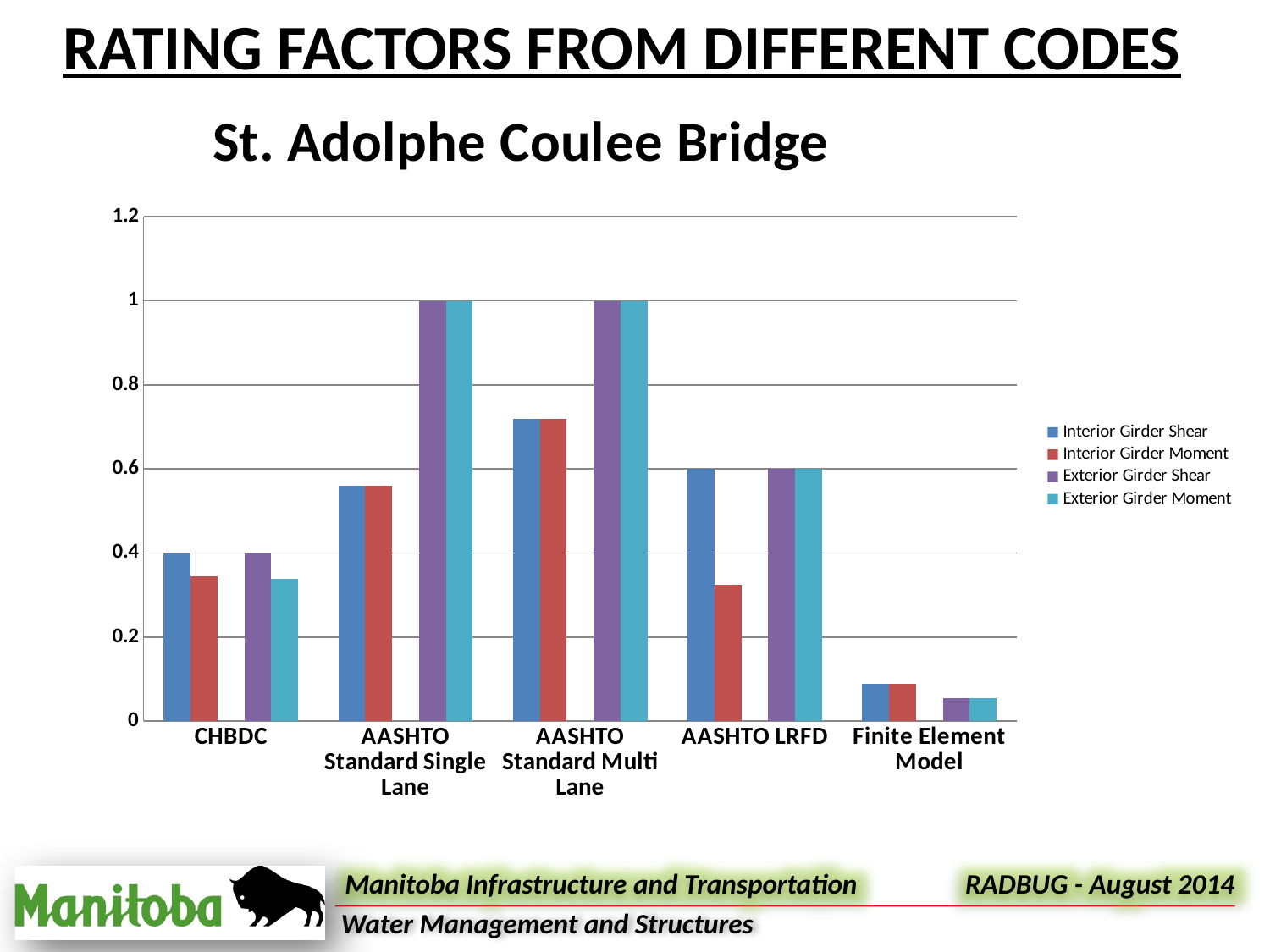
What is the Exterior Girder Shear value for AASHTO Standard Single Lane? 1 How many categories are shown on the x axis? 5 Is the Interior Girder Moment value for AASHTO LRFD greater or less than 0.4? less Which is larger for AASHTO LRFD: Interior Girder Shear or Interior Girder Moment? Interior Girder Shear Which category has the lowest Exterior Girder Moment value? Finite Element Model What is the title of the chart? St. Adolphe Coulee Bridge How many series does the legend list? 4 What is the Interior Girder Shear value for CHBDC? 0.4 What is the Exterior Girder Moment value for AASHTO Standard Multi Lane? 1 What type of chart is shown on the slide? bar chart Which category has the highest Interior Girder Shear value? AASHTO Standard Multi Lane What is the Interior Girder Shear value for AASHTO LRFD? 0.6